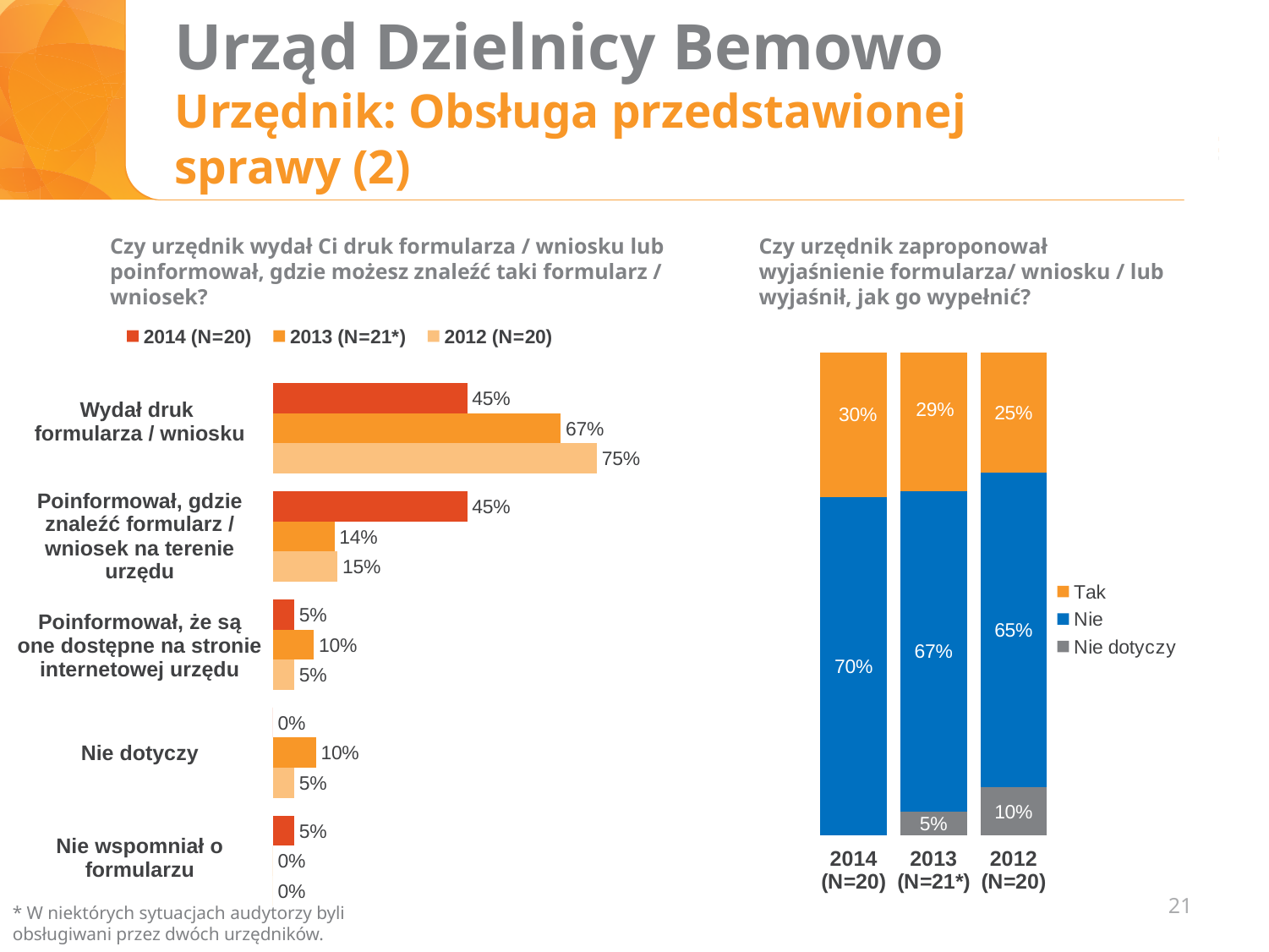
In the left chart, what is the difference between the 2012 and 2014 values for 'Wydał druk formularza / wniosku'? 30% How many series does the legend of the left chart list? 3 In the left chart, which category has the highest value for 2014 (N=20)? Wydał druk formularza / wniosku and Poinformował, gdzie znaleźć formularz / wniosek na terenie urzędu (tied at 45%) How many categories are shown in the left chart? 5 In the left chart, which is larger for 'Poinformował, że są one dostępne na stronie internetowej urzędu': the 2013 value or the 2014 value? 2013 (N=21*) In the left chart, what is the value for 'Poinformował, gdzie znaleźć formularz / wniosek na terenie urzędu' in 2013 (N=21*)? 14% What kind of chart is the left chart? Bar chart In the right chart, what is the total of the 2013 (N=21*) stacked bar? 101% In the left chart, what is the value for 'Wydał druk formularza / wniosku' in 2012 (N=20)? 75% In the right chart, which year has the highest 'Tak' share? 2014 (N=20) In the right chart, what is the 'Nie dotyczy' share for 2012 (N=20)? 10% In the right chart, what is the 'Nie' share for 2013 (N=21*)? 67%